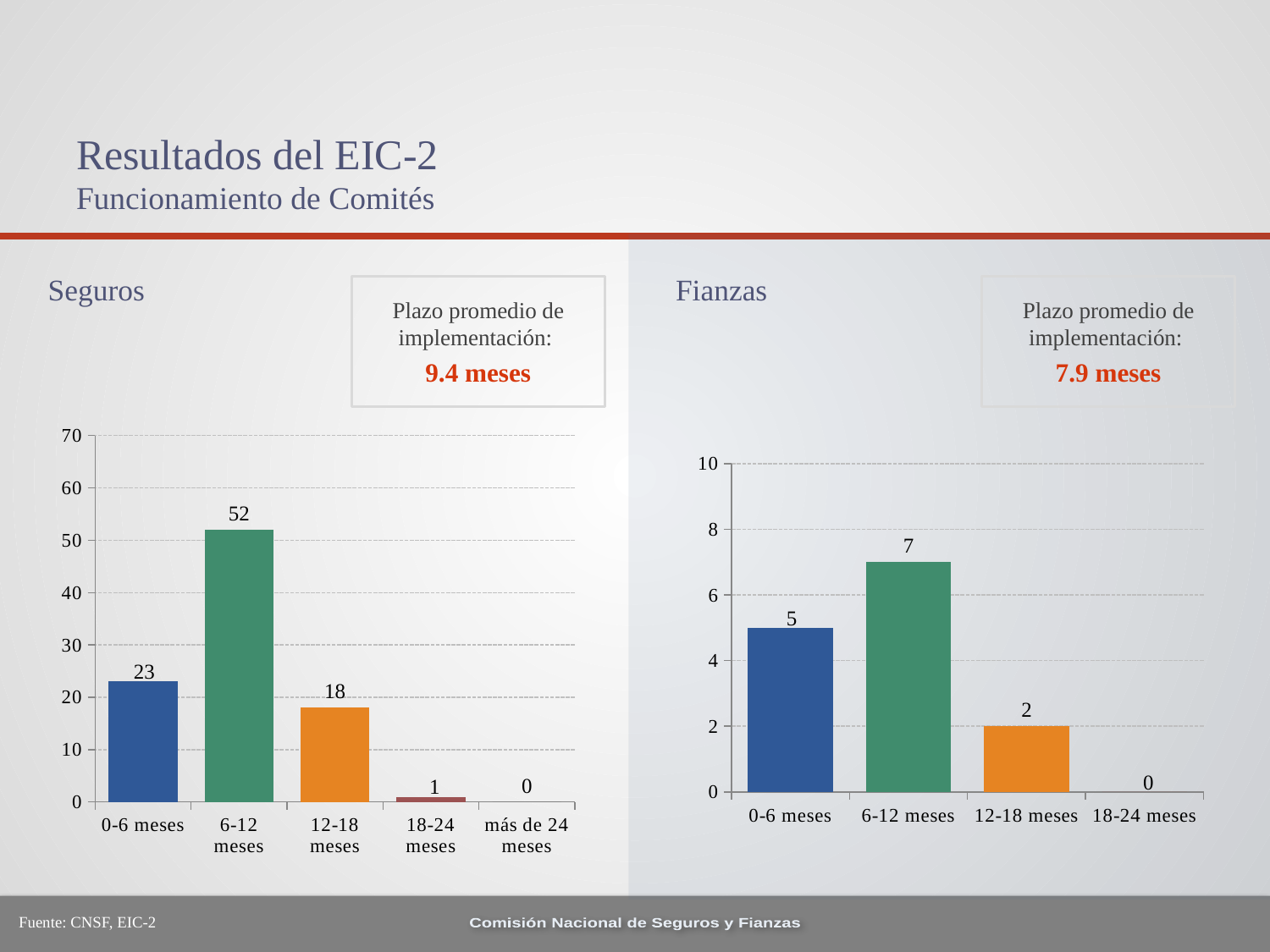
In the Seguros chart, which category has the lowest value? más de 24 meses In the Fianzas chart, what is the value for 12-18 meses? 2 What is the average implementation period (plazo promedio de implementación) shown for Seguros? 9.4 meses In the Seguros chart, which is larger, the value for 0-6 meses or the value for 12-18 meses? 0-6 meses In the Seguros chart, what is the value for 0-6 meses? 23 In the Fianzas chart, what is the difference between the values for 6-12 meses and 0-6 meses? 2 In the Seguros chart, what is the value for 6-12 meses? 52 In the Seguros chart, what is the difference between the values for 6-12 meses and 12-18 meses? 34 How many categories are shown on the x axis of the Fianzas chart? 4 What kind of chart is the Fianzas chart? bar chart In the Fianzas chart, which category has the highest value? 6-12 meses How many categories are shown on the x axis of the Seguros chart? 5